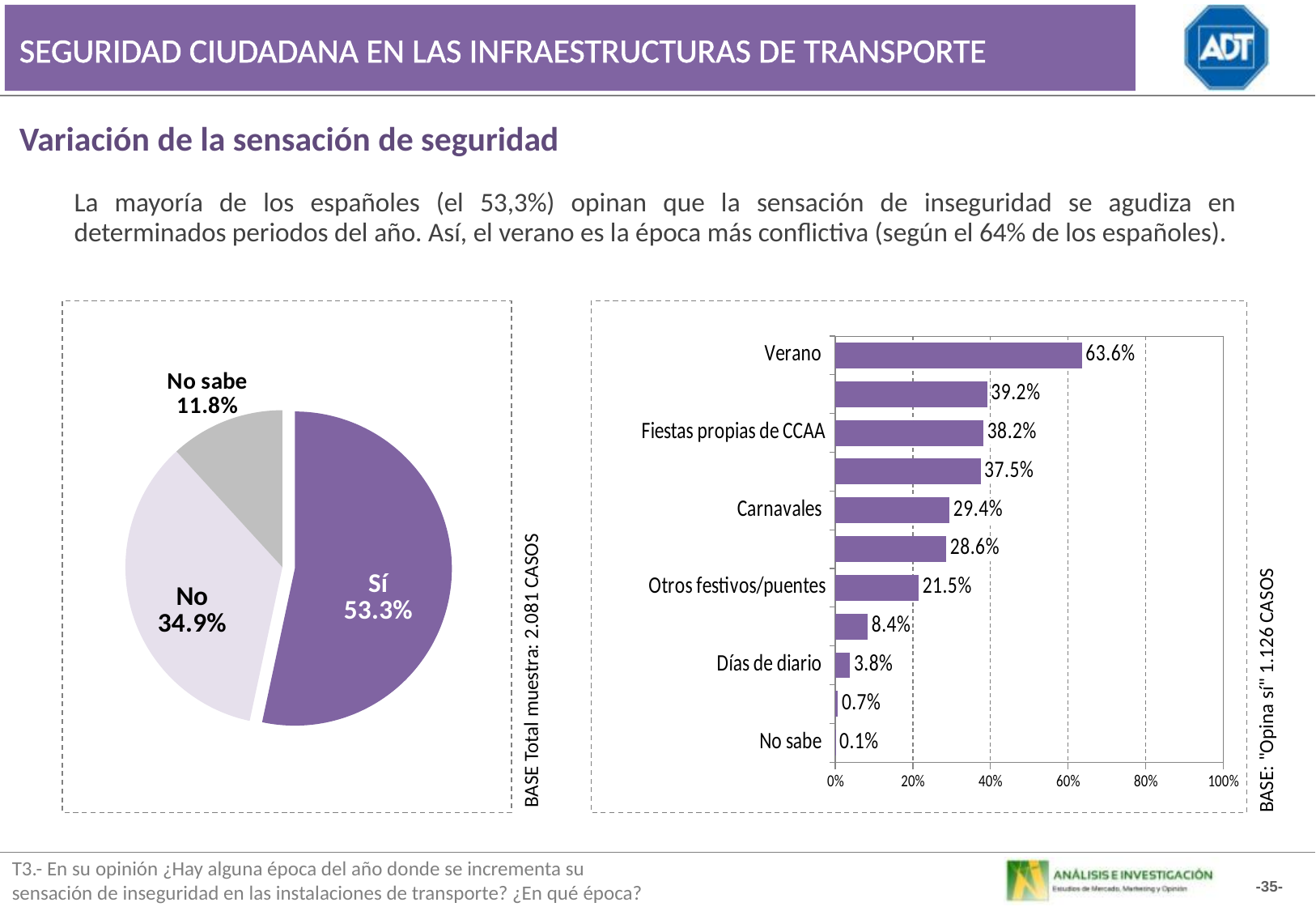
In the pie chart on the left, how many slices are there? 3 In the pie chart on the left, which slice is the largest? Sí In the bar chart on the right, what is the value for Carnavales? 29.4% What type of chart is shown on the right side of the slide? Bar chart In the pie chart on the left, what is the difference between the "Sí" and "No" shares? 18.4% In the bar chart on the right, which is larger, Otros festivos/puentes or Días de diario? Otros festivos/puentes In the bar chart on the right, which category has the lowest value? No sabe In the bar chart on the right, what is the value for Fiestas propias de CCAA? 38.2% In the pie chart on the left, what share of respondents answered "Sí"? 53.3% In the bar chart on the right, what is the value for Verano? 63.6% In the pie chart on the left, what share of respondents answered "No sabe"? 11.8% In the bar chart on the right, what is the difference between Verano and Carnavales? 34.2%